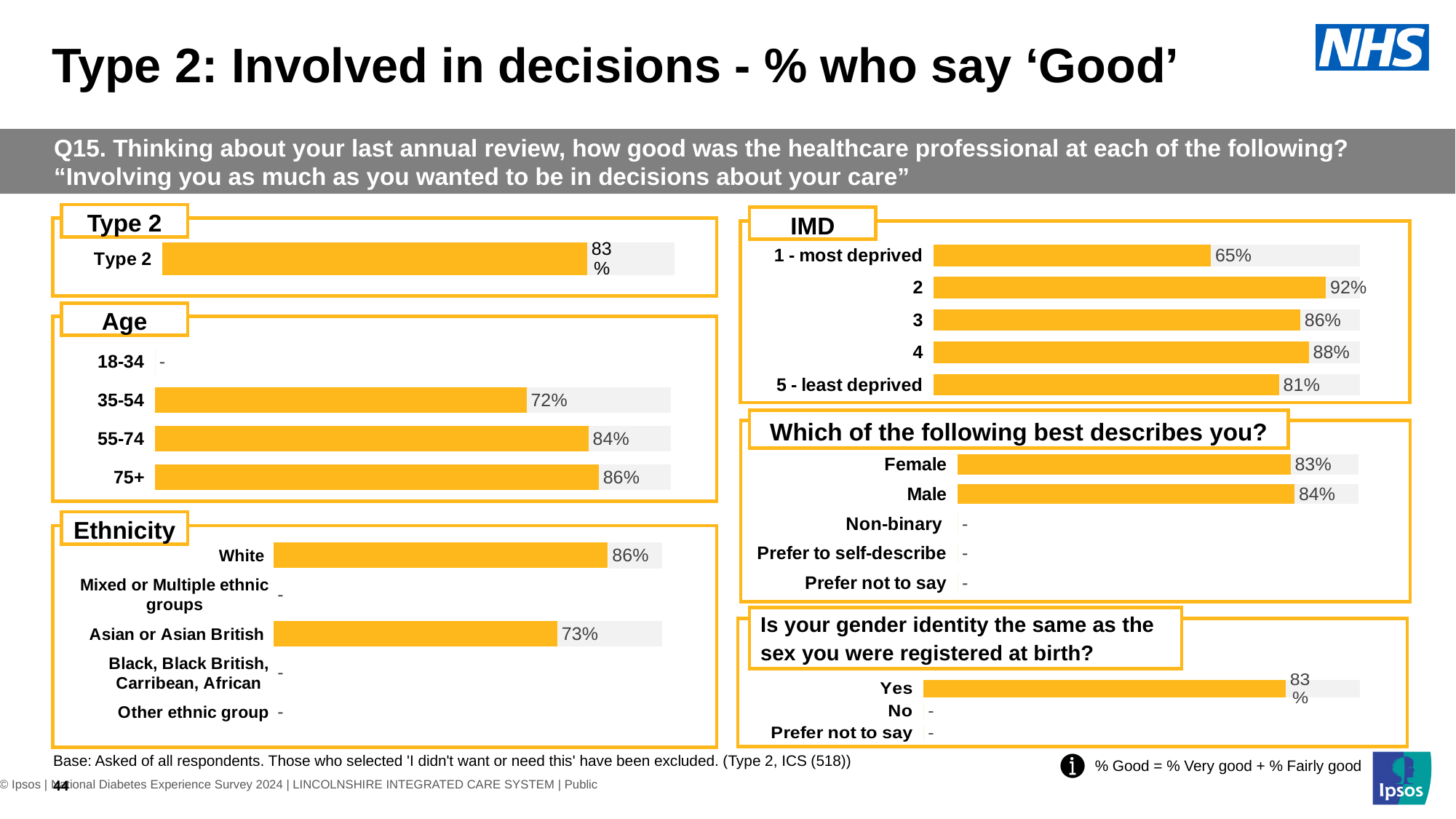
In the Age chart, what is the difference between the values for 75+ and 35-54? 14 percentage points In the IMD chart, which category has the lowest value? 1 - most deprived In the Type 2 chart, what is the value for Type 2? 83% In the IMD chart, what is the value for 5 - least deprived? 81% In the 'Which of the following best describes you?' chart, what is the value for Male? 84% In the Ethnicity chart, which is larger, the value for White or the value for Asian or Asian British? White In the Ethnicity chart, what is the value for Asian or Asian British? 73% In the IMD chart, what is the difference between the values for 2 and 1 - most deprived? 27 percentage points In the Age chart, what is the value for 35-54? 72% In the Age chart, which age group has the highest value? 75+ In the 'Is your gender identity the same as the sex you were registered at birth?' chart, what is the value for Yes? 83% In the IMD chart, which category has the highest value? 2